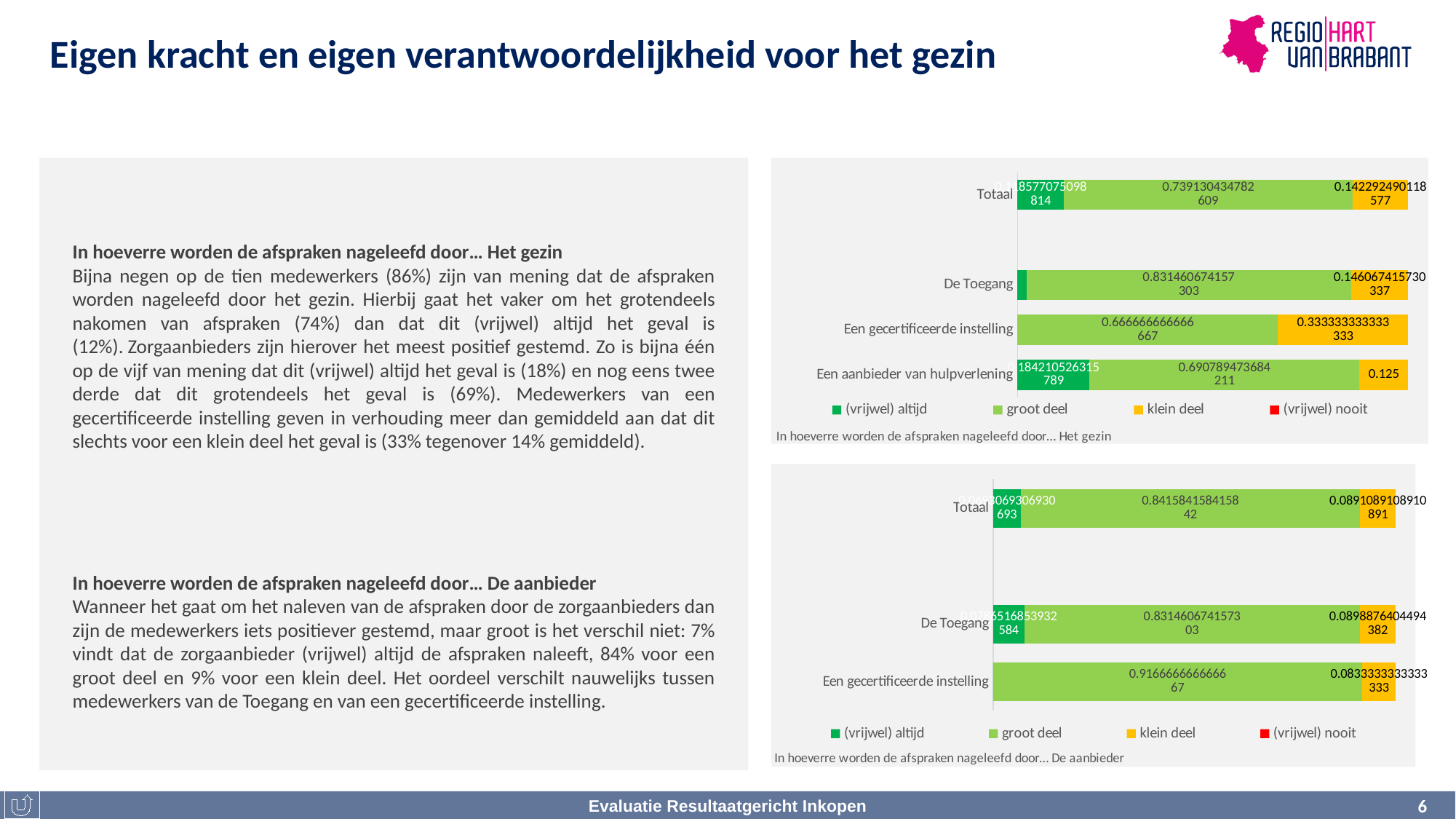
In the bottom chart ('De aanbieder'), which category has the highest 'groot deel' value? Een gecertificeerde instelling What kind of chart is the top chart, 'In hoeverre worden de afspraken nageleefd door... Het gezin'? Stacked bar chart In the bottom chart ('De aanbieder'), what is the 'klein deel' value for Totaal? 0.0891089108910891 In the top chart ('Het gezin'), what is the difference between the 'klein deel' values for Een gecertificeerde instelling and Een aanbieder van hulpverlening? 0.208333333333333 In the top chart ('Het gezin'), what is the 'klein deel' value for Een gecertificeerde instelling? 0.333333333333333 How many series does the legend of the top chart ('Het gezin') list? 4 In the bottom chart ('De aanbieder'), what is the 'groot deel' value for Een gecertificeerde instelling? 0.916666666666667 How many categories are shown in the top chart ('Het gezin')? 4 In the top chart ('Het gezin'), what is the 'groot deel' value for De Toegang? 0.831460674157303 In the top chart ('Het gezin'), what is the 'klein deel' value for Een aanbieder van hulpverlening? 0.125 How many categories are shown in the bottom chart ('De aanbieder')? 3 In the top chart ('Het gezin'), which category has the highest 'klein deel' value? Een gecertificeerde instelling